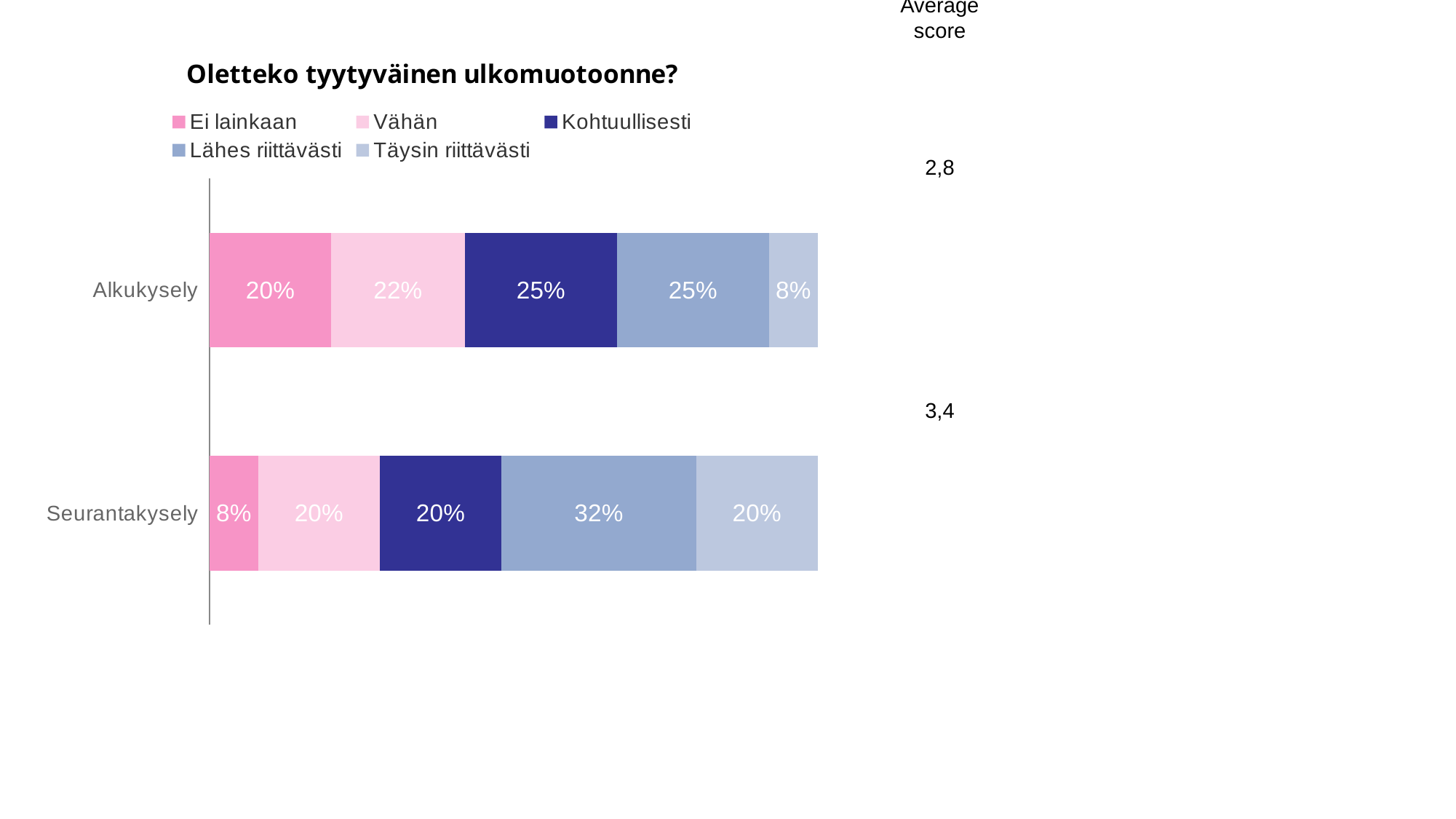
What is the difference between the "Täysin riittävästi" share in Seurantakysely and in Alkukysely? 12 percentage points What percentage of Seurantakysely respondents answered "Lähes riittävästi"? 32% What percentage of Alkukysely respondents answered "Ei lainkaan"? 20% Which survey has the larger share of "Ei lainkaan" responses, Alkukysely or Seurantakysely? Alkukysely What is the average score shown for Seurantakysely? 3,4 How many bars (survey rounds) are shown in the chart? 2 How many series does the legend list? 5 What percentage of Seurantakysely respondents answered "Vähän"? 20% What kind of chart is shown on the slide? Stacked bar chart Which response category has the largest share in the Seurantakysely bar? Lähes riittävästi What percentage of Alkukysely respondents answered "Täysin riittävästi"? 8% Which response category has the smallest share in the Alkukysely bar? Täysin riittävästi